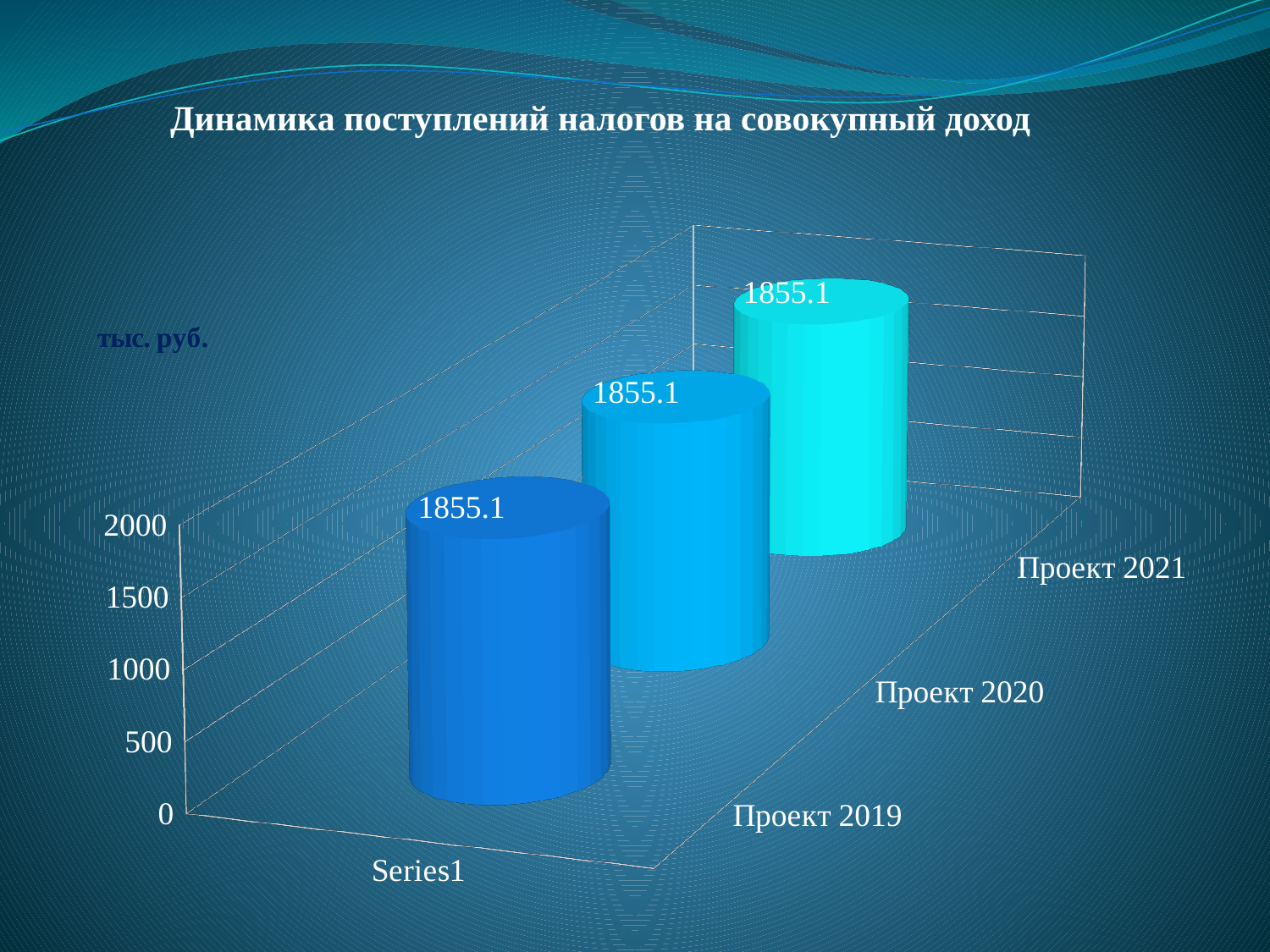
Is the value for Проект 2021 greater or less than 2000? less What is the value for Проект 2020? 1855.1 What unit is shown for the values on the chart? тыс. руб. What is the value for Проект 2019? 1855.1 How many categories are plotted on the chart? 3 What kind of chart is shown on the slide? bar chart What is the difference between the values for Проект 2021 and Проект 2019? 0 What is the title of the chart? Динамика поступлений налогов на совокупный доход Is the value for Проект 2020 greater or less than 1500? greater Do the values rise, fall or stay the same from Проект 2019 to Проект 2021? stay the same What is the value for Проект 2021? 1855.1 What is the highest tick value shown on the vertical axis? 2000